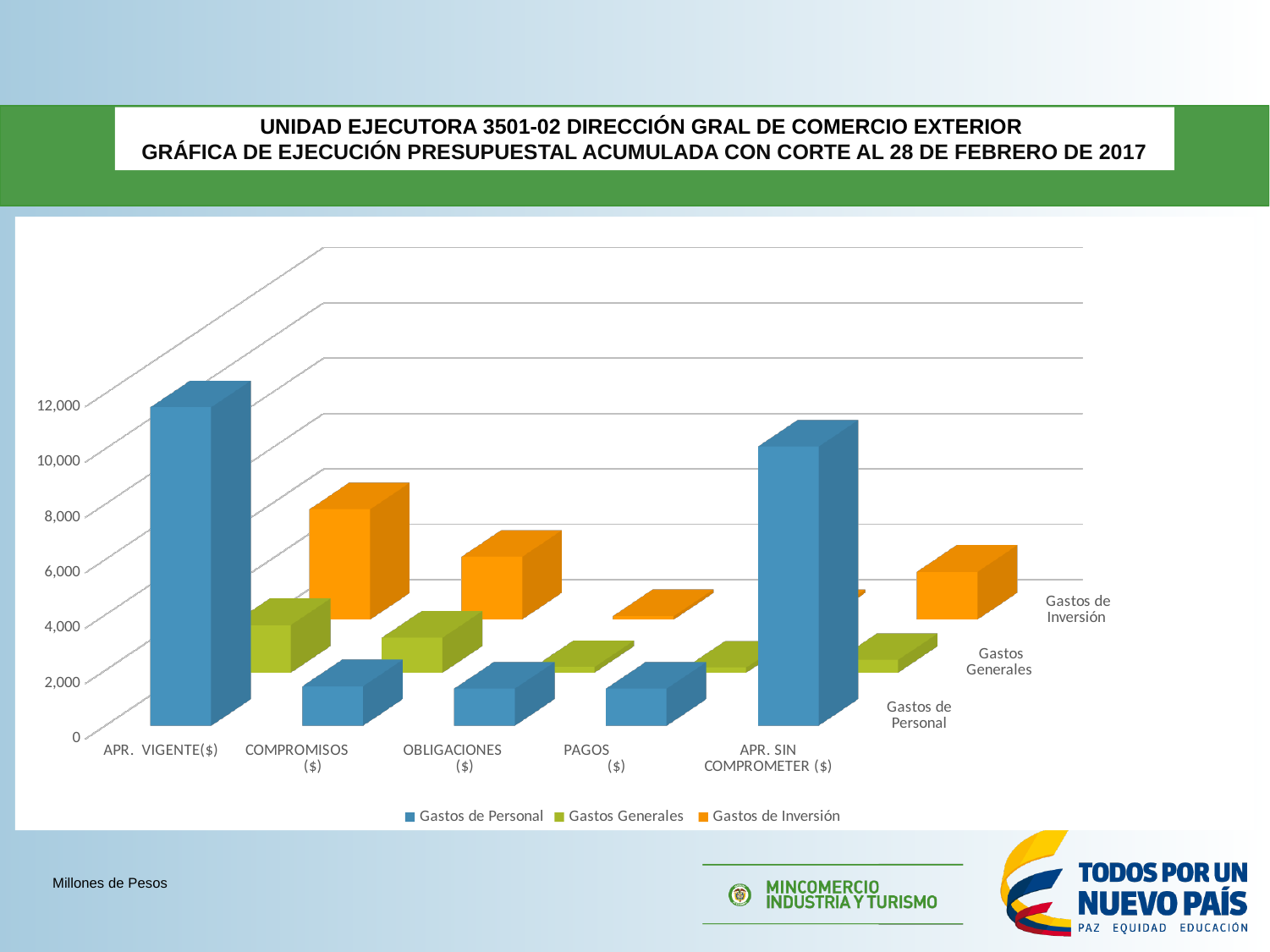
Is the value of Gastos de Inversión for PAGOS ($) greater or less than 2,000? less How many categories are shown along the x axis? 5 What kind of chart is shown on the slide? bar chart For COMPROMISOS ($), which is larger: Gastos de Personal or Gastos de Inversión? Gastos de Inversión Is the value of Gastos de Personal for APR. VIGENTE($) greater or less than 10,000? greater How many series does the legend list? 3 Is the value of Gastos de Personal for COMPROMISOS ($) greater or less than 4,000? less Which category has the highest value for Gastos de Personal? APR. VIGENTE($) Which series is shown in orange in the legend? Gastos de Inversión For APR. VIGENTE($), which is larger: Gastos de Personal or Gastos de Inversión? Gastos de Personal